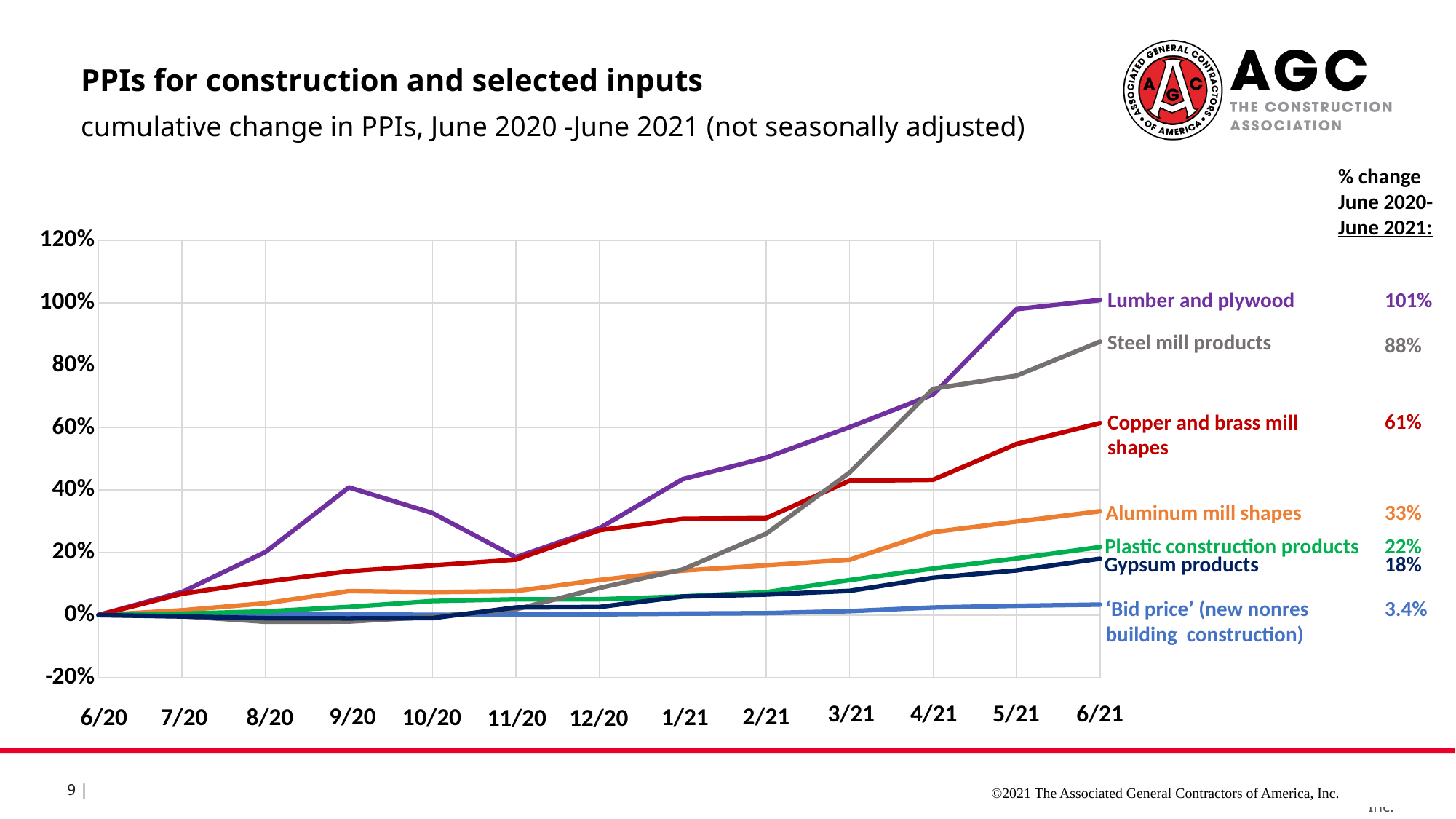
Is the value for Steel mill products at 2/21 greater or less than 40%? less What kind of chart is shown on the slide? Line chart What is the % change from June 2020 to June 2021 for Lumber and plywood? 101% Which series has the highest cumulative change from June 2020 to June 2021? Lumber and plywood How many series are plotted on the chart? 7 What is the % change from June 2020 to June 2021 for 'Bid price' (new nonres building construction)? 3.4% Which has a larger June 2020-June 2021 % change, Plastic construction products or Gypsum products? Plastic construction products How many months are shown along the x axis? 13 Which series has the lowest cumulative change from June 2020 to June 2021? 'Bid price' (new nonres building construction) What is the difference between the June 2020-June 2021 % change for Copper and brass mill shapes and Aluminum mill shapes? 28% Is the value for Lumber and plywood at 9/20 greater or less than 20%? greater What is the % change from June 2020 to June 2021 for Steel mill products? 88%